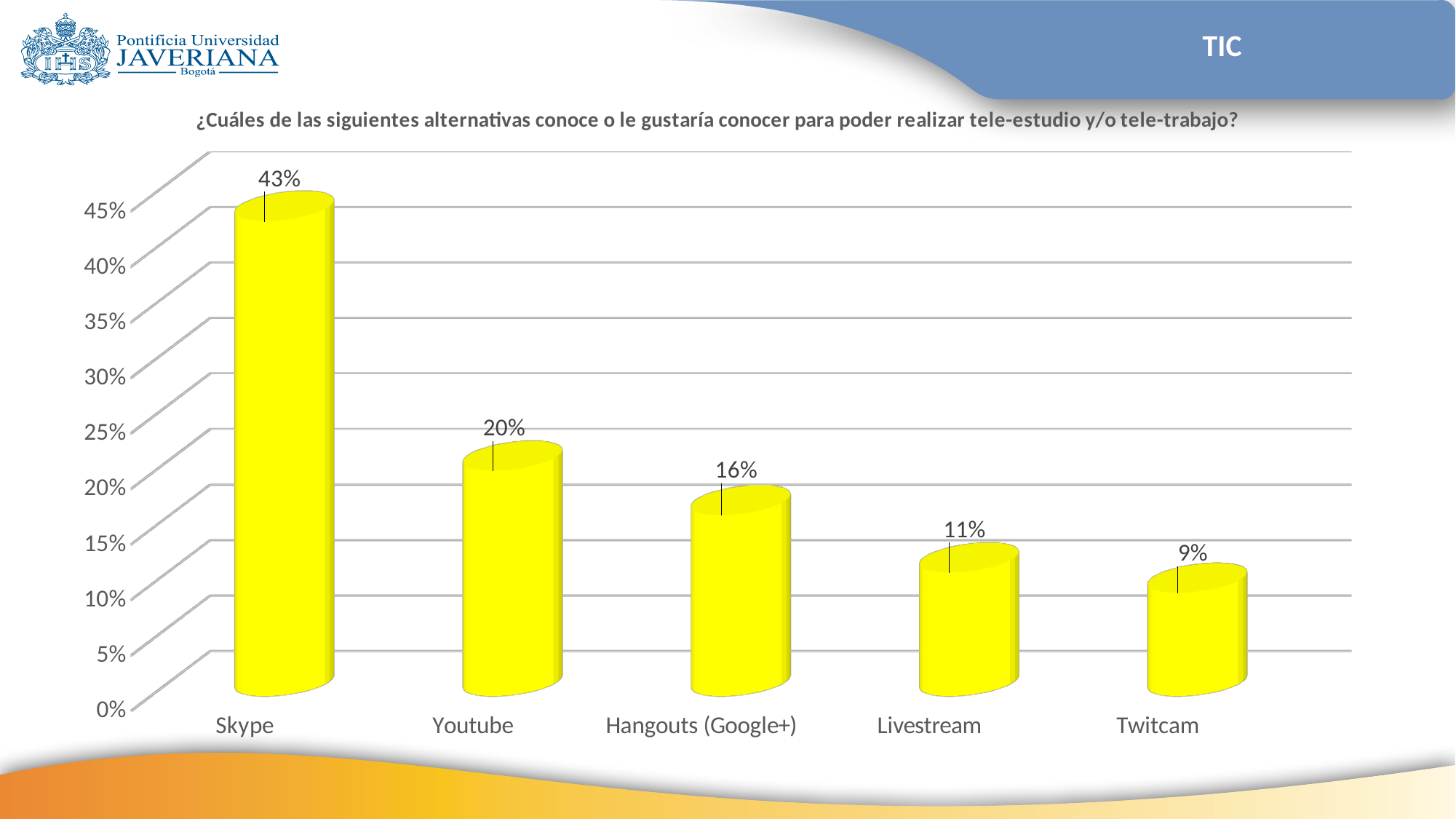
What is the value for Livestream? 11% What kind of chart is shown on the slide? Bar chart What is the value for Hangouts (Google+)? 16% What is the value for Youtube? 20% What is the value for Skype? 43% How many categories are shown on the x axis? 5 What is the value for Twitcam? 9% Which is larger, the value for Hangouts (Google+) or the value for Livestream? Hangouts (Google+) Which category has the highest value? Skype What is the difference between the values for Skype and Youtube? 23% Do the values rise or fall from left to right along the x axis? Fall Which category has the lowest value? Twitcam